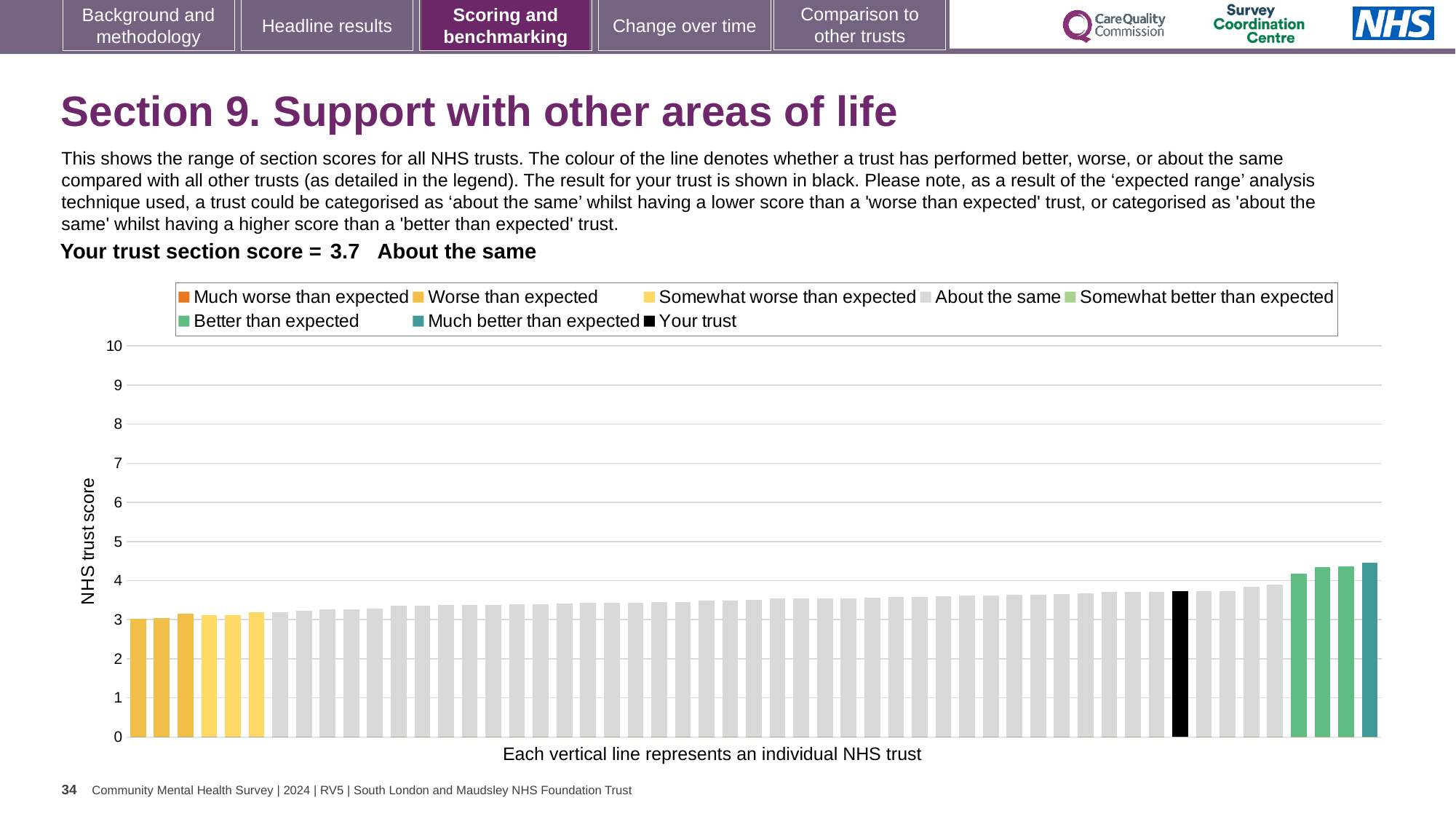
Which is higher, the black bar for your trust or the rightmost teal bar? the rightmost teal bar Do the bar values rise or fall moving from left to right along the x axis? rise Is the value for your trust (the black bar) greater or less than 4? less Is the value of the leftmost bar greater or less than 2? greater Is the value for your trust (the black bar) greater or less than 3? greater What is the section score for your trust shown on the slide? 3.7 What colour is used for the bar representing your trust? black What kind of chart is shown on the slide? bar chart What is the label on the vertical axis of the chart? NHS trust score Which performance category is your trust placed in for this section? About the same How many entries does the chart legend list? 8